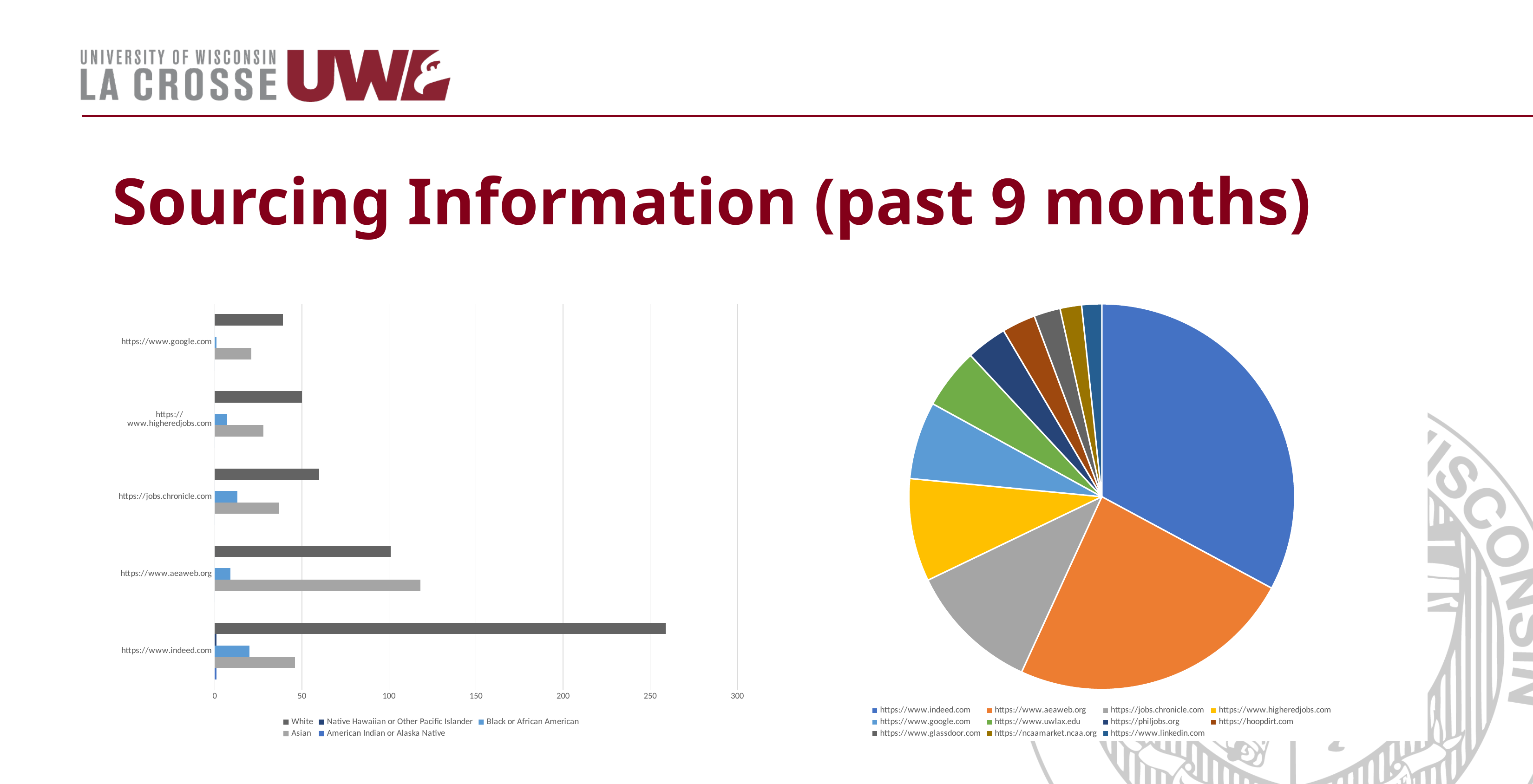
What kind of chart is the chart on the right of the slide? pie chart What kind of chart is the chart on the left of the slide? bar chart In the pie chart on the right, which slice is larger: https://www.aeaweb.org or https://jobs.chronicle.com? https://www.aeaweb.org In the bar chart on the left, is the White value for https://www.indeed.com greater or less than 250? greater In the bar chart on the left, for https://www.aeaweb.org, which is larger: the Asian value or the White value? Asian In the pie chart on the right, how many sources does the legend list? 11 In the pie chart on the right, which source has the largest slice? https://www.indeed.com In the bar chart on the left, is the White value for https://www.google.com greater or less than 50? less In the bar chart on the left, is the Asian value for https://www.aeaweb.org greater or less than 100? greater In the bar chart on the left, which website has the highest value for the White series? https://www.indeed.com In the bar chart on the left, how many website categories are shown on the vertical axis? 5 In the bar chart on the left, how many series does the legend list? 5